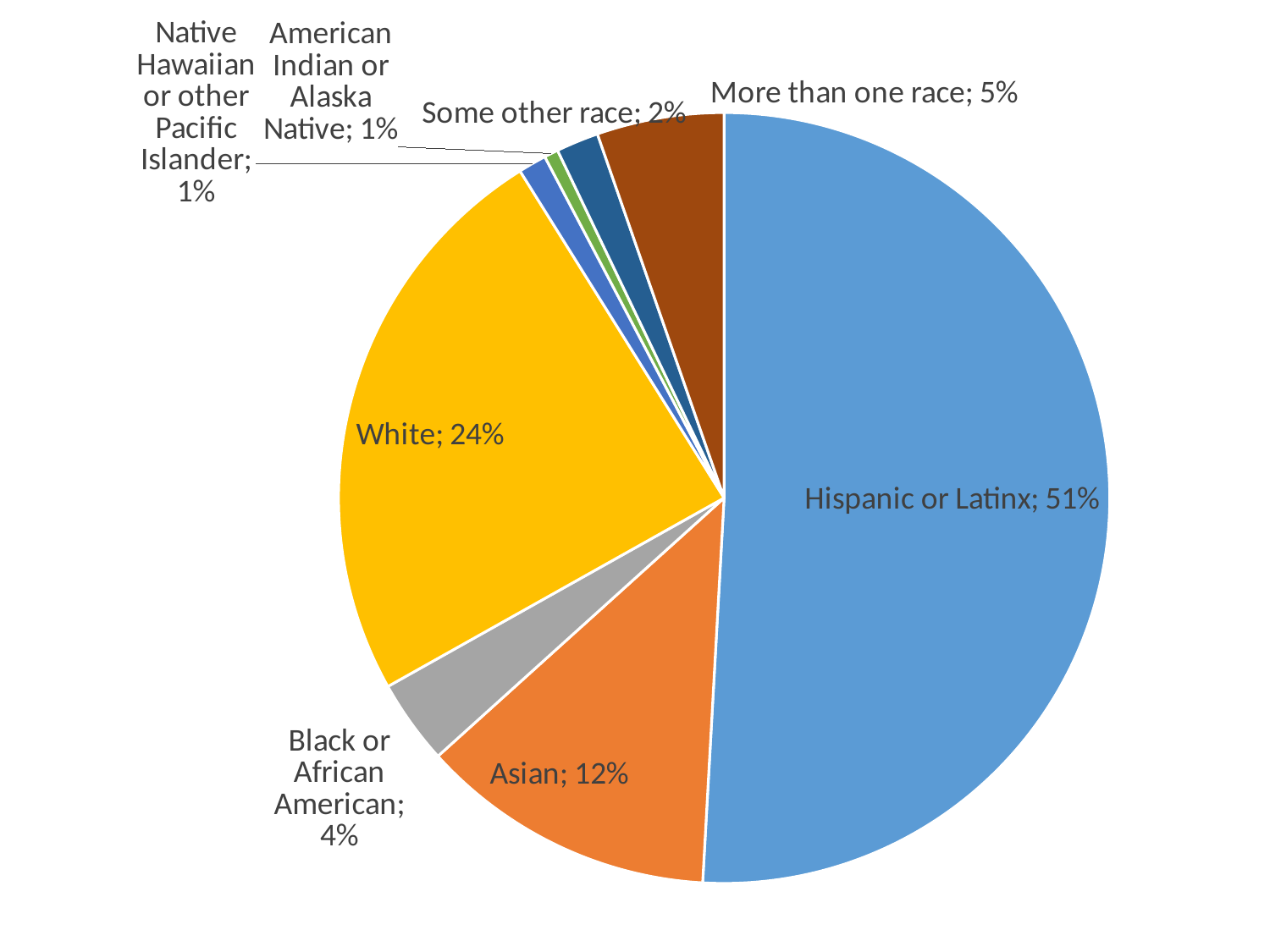
What is the difference between the White and Asian shares? 12% What colour is the Hispanic or Latinx slice? Blue What is the value for Asian? 12% What is the value for More than one race? 5% What share of the pie is Hispanic or Latinx? 51% What is the value for Some other race? 2% What is the value for Black or African American? 4% Which is larger, the share for More than one race or the share for Black or African American? More than one race What kind of chart is shown on the slide? Pie chart What is the value for White? 24% Which category has the largest slice of the pie? Hispanic or Latinx How many slices does the pie chart have? 8